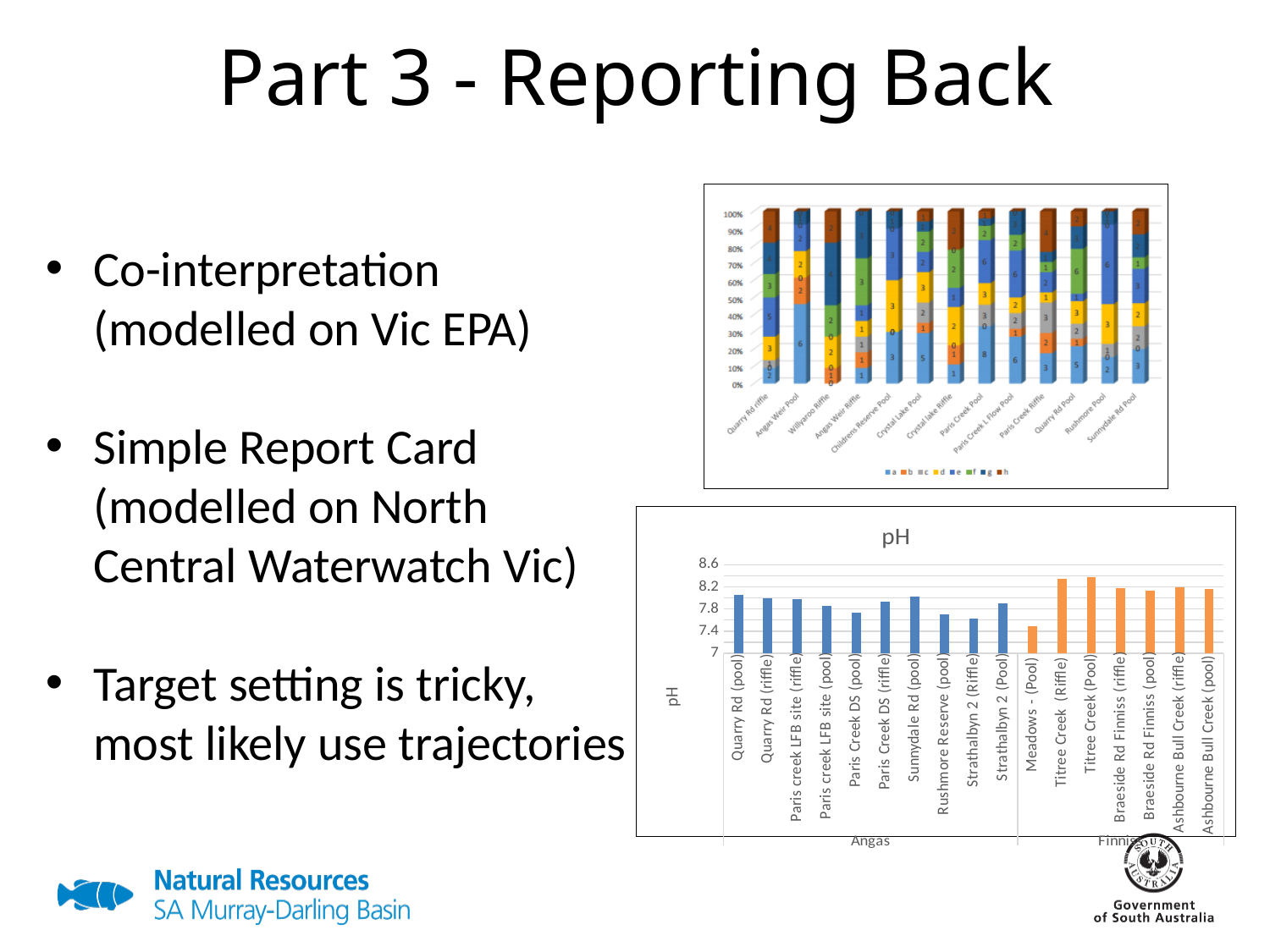
On the bottom chart titled pH, is the value for Titree Creek (Pool) greater or less than 8.2? greater On the bottom chart titled pH, what kind of chart is shown? bar chart On the bottom chart titled pH, which has the higher pH: Titree Creek (Pool) or Meadows - (Pool)? Titree Creek (Pool) On the top stacked bar chart, how many series does the legend list? 8 On the bottom chart titled pH, which site has the lowest pH value? Meadows - (Pool) On the bottom chart titled pH, which has the higher pH: Quarry Rd (pool) or Strathalbyn 2 (Riffle)? Quarry Rd (pool) On the bottom chart titled pH, how many bars (sites) are plotted? 17 On the bottom chart titled pH, is the value for Braeside Rd Finniss (pool) greater or less than 7.8? greater On the bottom chart titled pH, is the value for Quarry Rd (pool) greater or less than 7.8? greater On the top chart, what kind of chart is shown? stacked bar chart On the bottom chart titled pH, what are the two catchment groups labelled along the x axis? Angas and Finniss